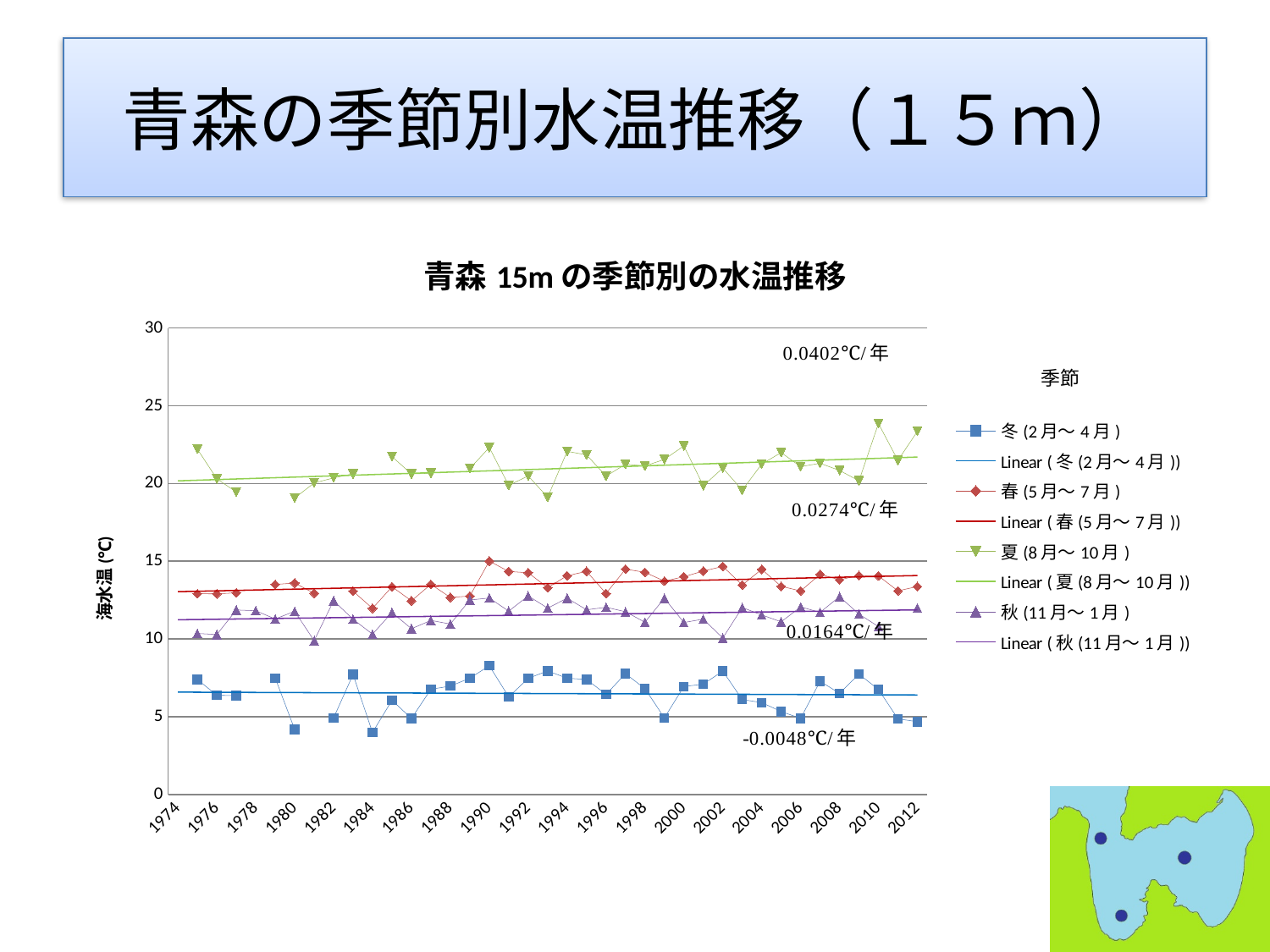
What trend rate is annotated for the spring (春) series? 0.0274℃/年 Which season series has the lowest water temperatures? 冬 (2月～4月) Which season series has the highest water temperatures? 夏 (8月～10月) What is the title of the chart? 青森 15m の季節別の水温推移 Which series has higher values, 春 (5月～7月) or 秋 (11月～1月)? 春 (5月～7月) What trend rate is annotated for the summer (夏) series? 0.0402℃/年 How many entries does the legend list? 8 What is the label of the vertical axis? 海水温 (℃) Is the value for 夏 (8月～10月) in 2010 greater or less than 20? greater What kind of chart is shown on the slide? line chart Does the linear trend line for 夏 (8月～10月) rise or fall from 1974 to 2012? rise What trend rate is annotated for the winter (冬) series? -0.0048℃/年